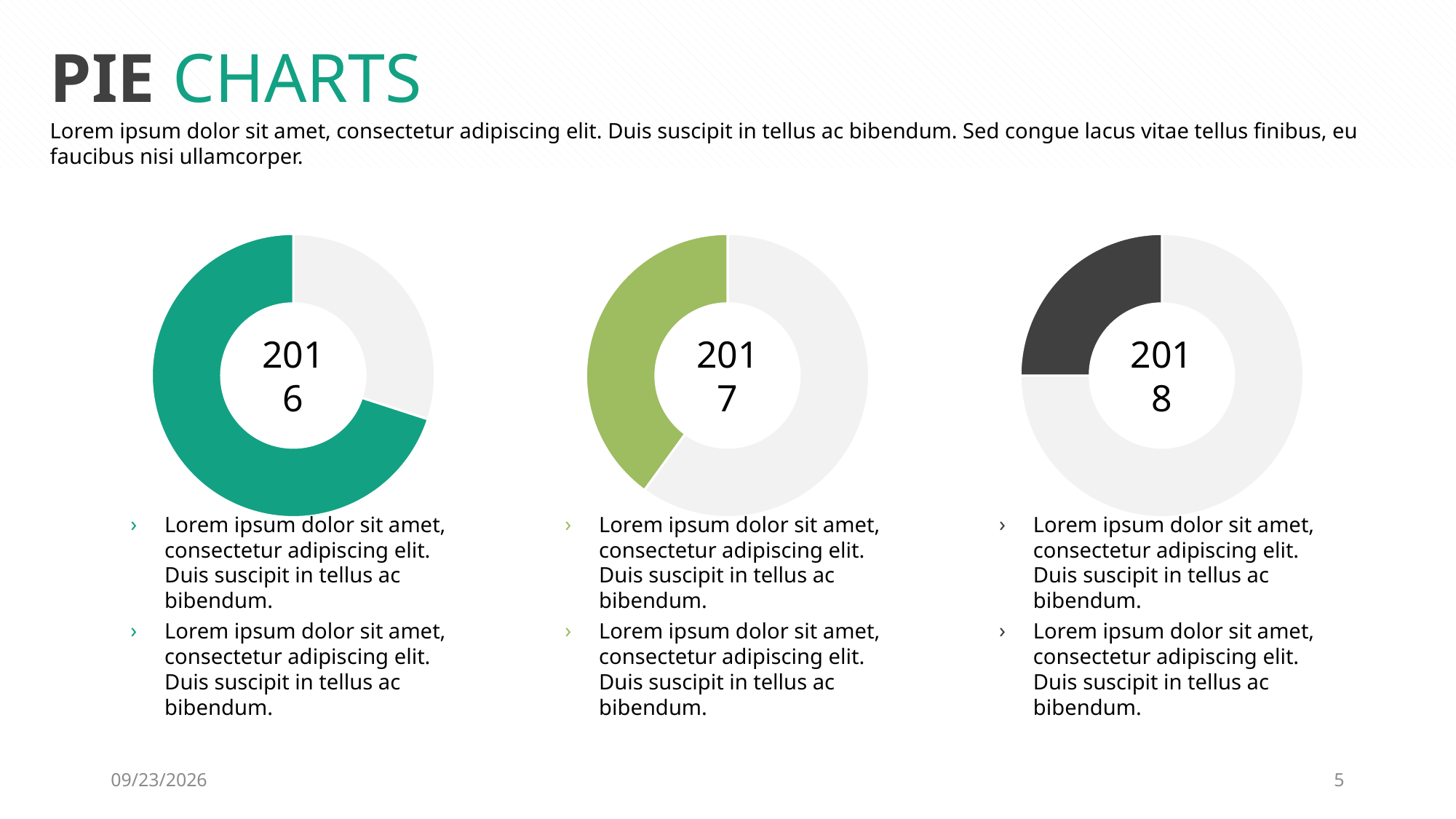
Which of the three pie charts has the largest coloured slice? 2016 Which pie chart has a larger coloured slice, 2017 or 2018? 2017 What label is shown in the centre of the right-hand pie chart? 2018 How many pie charts are on the slide? 3 What kind of chart is shown for 2016? Pie chart (donut) Which of the three pie charts has the smallest coloured slice? 2018 What label is shown in the centre of the left-hand pie chart? 2016 How many slices does each pie chart have? 2 Which pie chart has a larger coloured slice, 2016 or 2017? 2016 In the 2016 pie chart, is the coloured slice larger or smaller than half of the pie? larger Does the size of the coloured slice increase or decrease from the 2016 chart to the 2018 chart? decrease